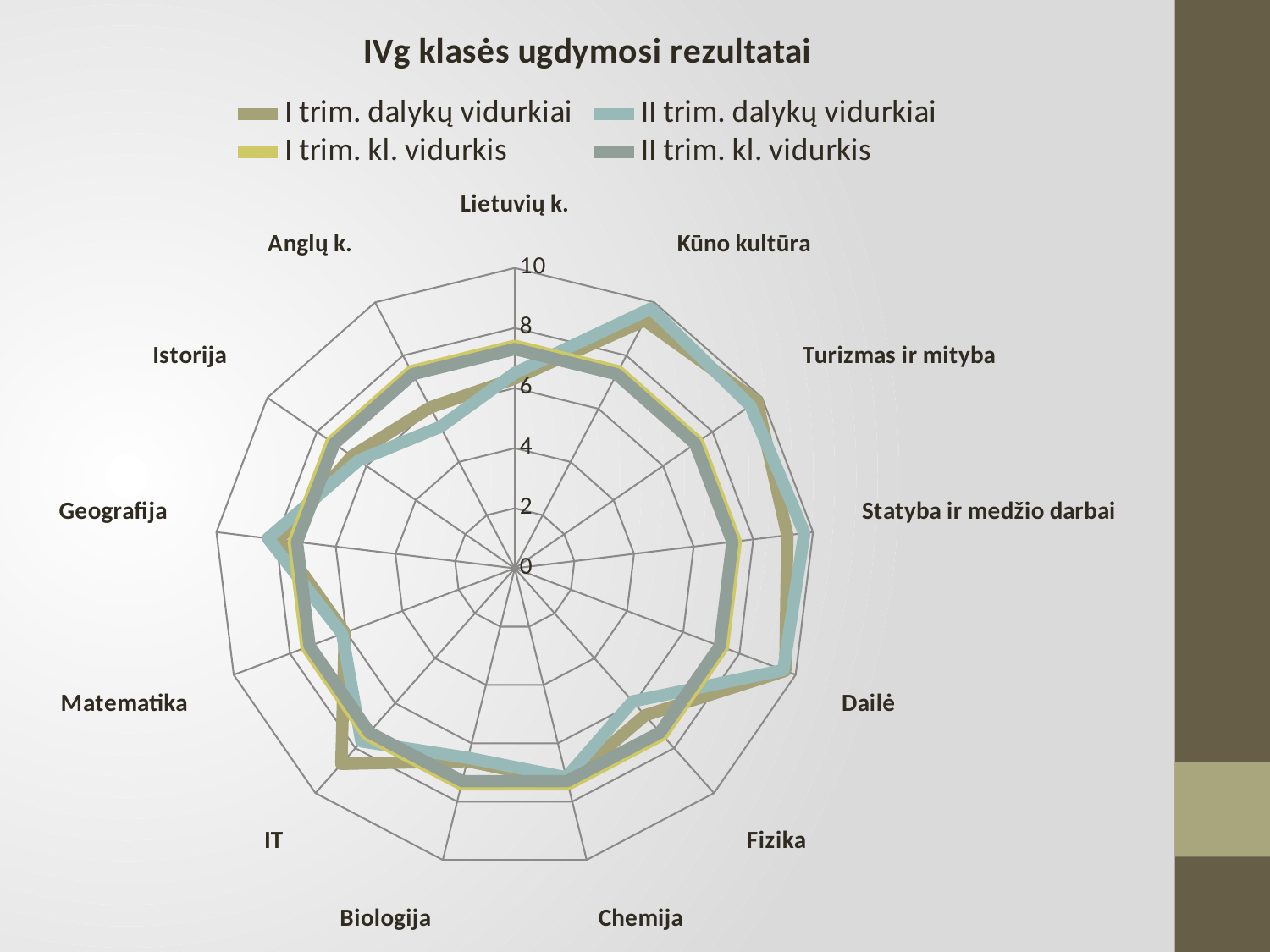
What is the maximum value shown on the radial axis? 10 How many series does the legend list? 4 Which series is shown in light blue in the legend? II trim. dalykų vidurkiai Is the value of I trim. dalykų vidurkiai for Lietuvių k. greater or less than 8? less Is the value of II trim. dalykų vidurkiai for Chemija greater or less than 8? less Is the value of II trim. dalykų vidurkiai for Dailė greater or less than 8? greater What kind of chart is shown on the slide? Radar chart How many subject categories are plotted on the radar chart? 13 What is the title of the chart? IVg klasės ugdymosi rezultatai